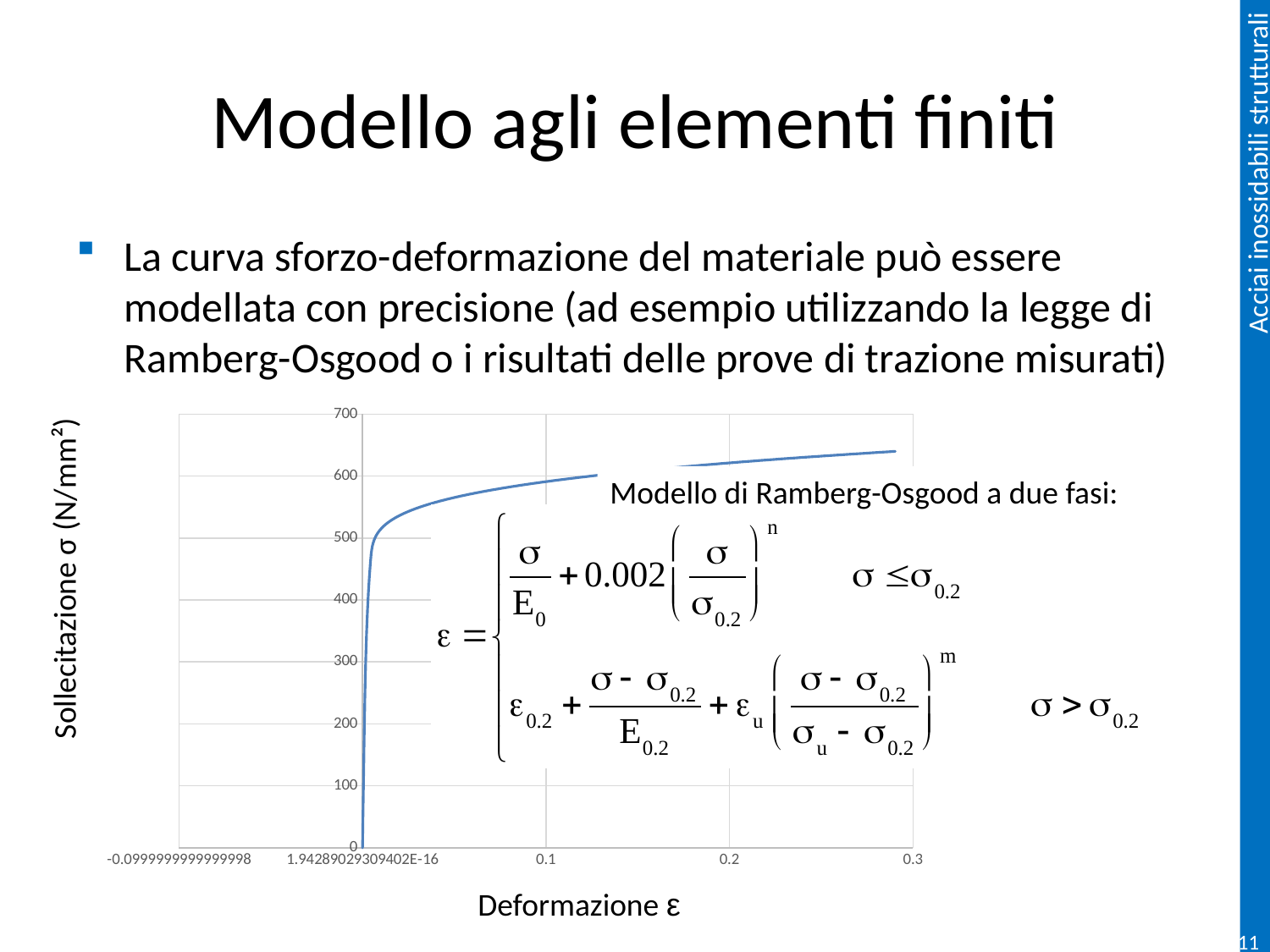
Is the stress value at a strain of 0.1 greater or less than 500? greater What kind of chart is shown on the slide? line chart Is the stress value at a strain of 0.3 greater or less than 600? greater Does the stress value rise or fall as the strain ε increases along the x axis? rise What is the highest value shown on the vertical axis of the chart? 700 What is the label of the horizontal axis of the chart? Deformazione ε Is the stress value at a strain of 0.3 greater or less than 700? less